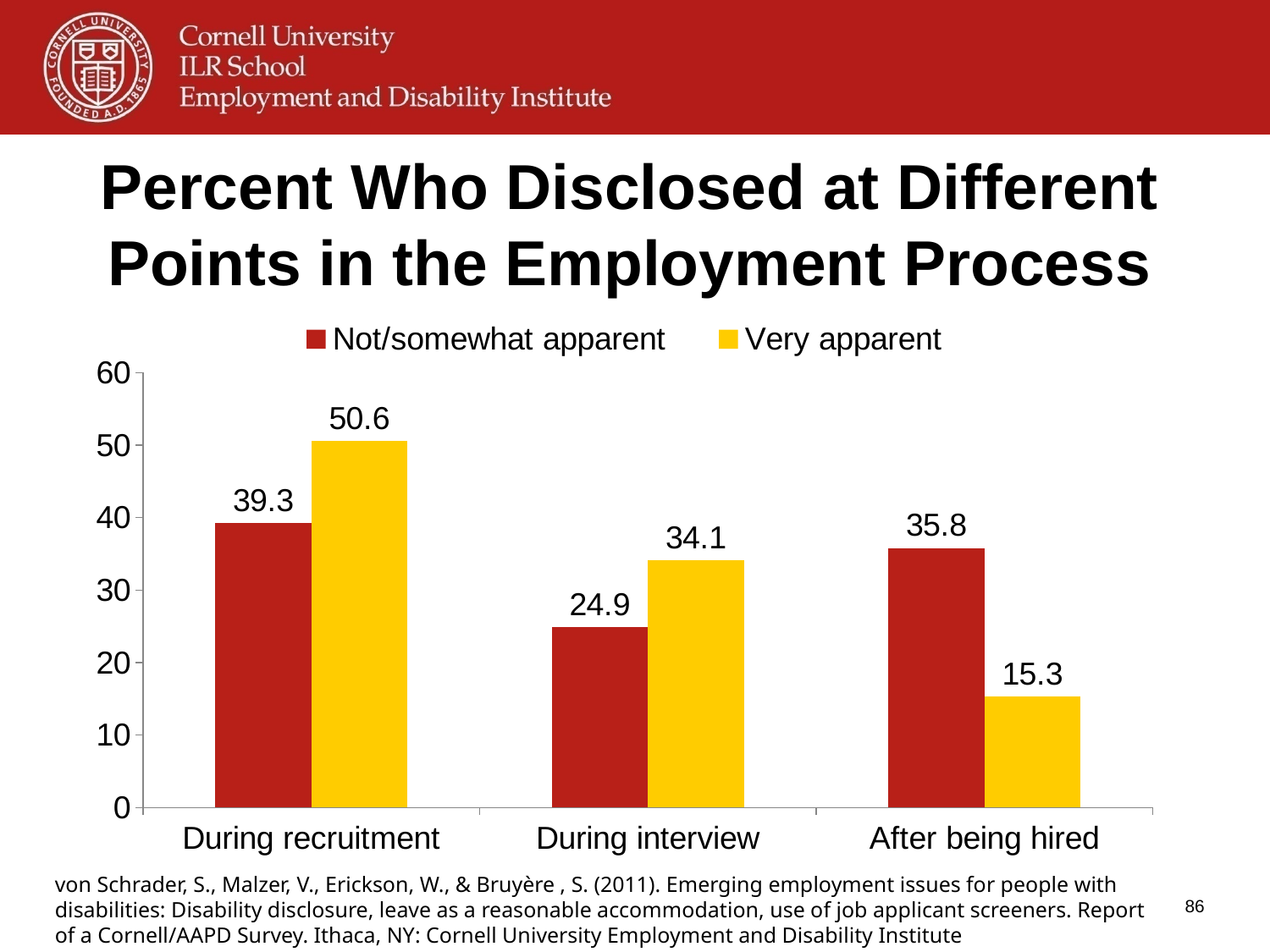
What is the value for Not/somewhat apparent during interview? 24.9 Which category has the highest value for the Not/somewhat apparent series? During recruitment Is the value for Not/somewhat apparent after being hired greater or less than 30? greater How many categories are shown on the x axis? 3 Does the Very apparent series rise or fall across the categories from left to right? Fall What is the difference between the Very apparent and Not/somewhat apparent values during recruitment? 11.3 Which category has the lowest value for the Very apparent series? After being hired Which is larger after being hired: Not/somewhat apparent or Very apparent? Not/somewhat apparent What kind of chart is shown on the slide? Bar chart What is the value for Very apparent during recruitment? 50.6 What is the value for Very apparent after being hired? 15.3 How many series does the legend list? 2